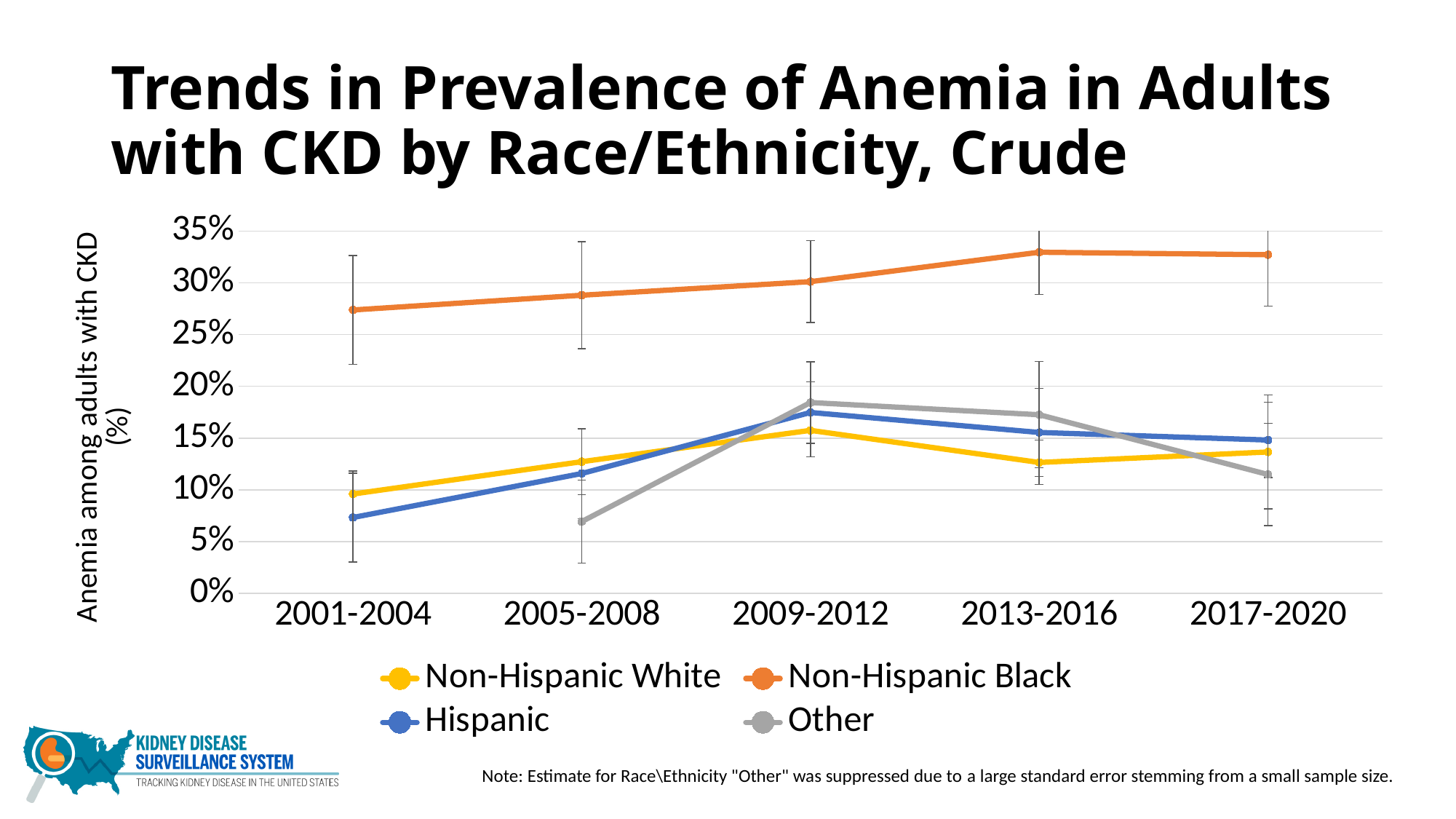
How many time periods are shown on the x axis? 5 Which race/ethnicity group has the highest anemia prevalence in 2017-2020? Non-Hispanic Black Is the value for Hispanic in 2001-2004 greater or less than 10%? less Does the Non-Hispanic Black line rise or fall from 2001-2004 to 2013-2016? rises Which race/ethnicity group has the lowest anemia prevalence in 2001-2004? Hispanic Is the value for Non-Hispanic Black in 2001-2004 greater or less than 25%? greater In which time period does the Non-Hispanic White series reach its highest value? 2009-2012 Is the value for Other in 2009-2012 greater or less than 15%? greater How many series does the legend list? 4 In 2009-2012, which is larger: the value for Hispanic or the value for Non-Hispanic White? Hispanic What kind of chart is shown on the slide? line chart For which time period is there no plotted point for the Other series? 2001-2004